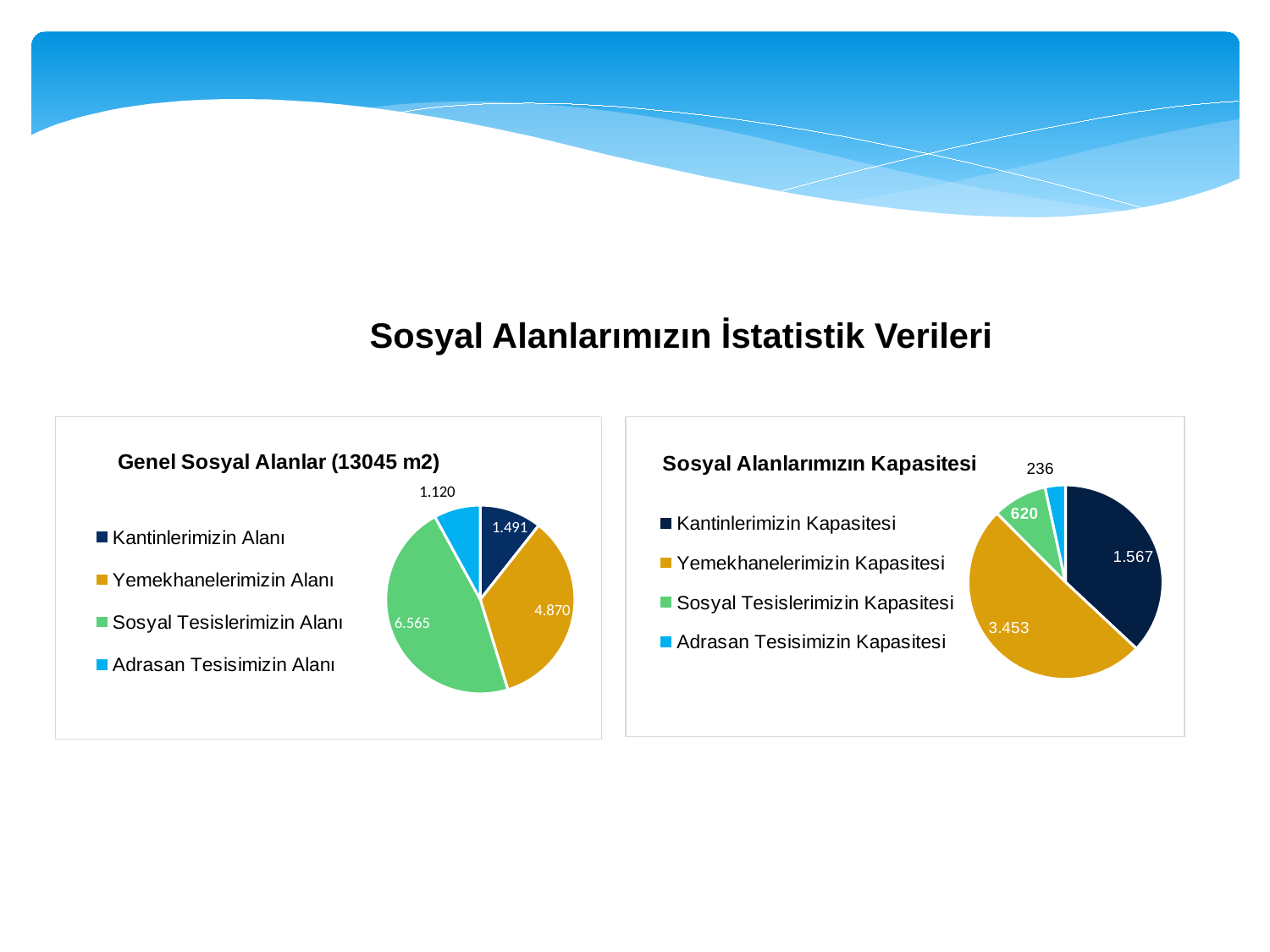
In the 'Sosyal Alanlarımızın Kapasitesi' chart, what is the value for Adrasan Tesisimizin Kapasitesi? 236 In the 'Sosyal Alanlarımızın Kapasitesi' chart, what is the difference between Sosyal Tesislerimizin Kapasitesi and Adrasan Tesisimizin Kapasitesi? 384 In the 'Sosyal Alanlarımızın Kapasitesi' chart, what is the value for Yemekhanelerimizin Kapasitesi? 3.453 In the 'Genel Sosyal Alanlar (13045 m2)' chart, what is the difference between Sosyal Tesislerimizin Alanı and Yemekhanelerimizin Alanı? 1.695 In the 'Genel Sosyal Alanlar (13045 m2)' chart, what is the value for Adrasan Tesisimizin Alanı? 1.120 How many categories does the 'Sosyal Alanlarımızın Kapasitesi' chart show? 4 In the 'Sosyal Alanlarımızın Kapasitesi' chart, which is larger: Kantinlerimizin Kapasitesi or Sosyal Tesislerimizin Kapasitesi? Kantinlerimizin Kapasitesi In the 'Genel Sosyal Alanlar (13045 m2)' chart, what is the value for Sosyal Tesislerimizin Alanı? 6.565 In the 'Genel Sosyal Alanlar (13045 m2)' chart, which category has the largest slice? Sosyal Tesislerimizin Alanı In the 'Genel Sosyal Alanlar (13045 m2)' chart, which category has the smallest slice? Adrasan Tesisimizin Alanı In the 'Sosyal Alanlarımızın Kapasitesi' chart, which category has the largest slice? Yemekhanelerimizin Kapasitesi What kind of chart is the 'Genel Sosyal Alanlar (13045 m2)' chart? Pie chart